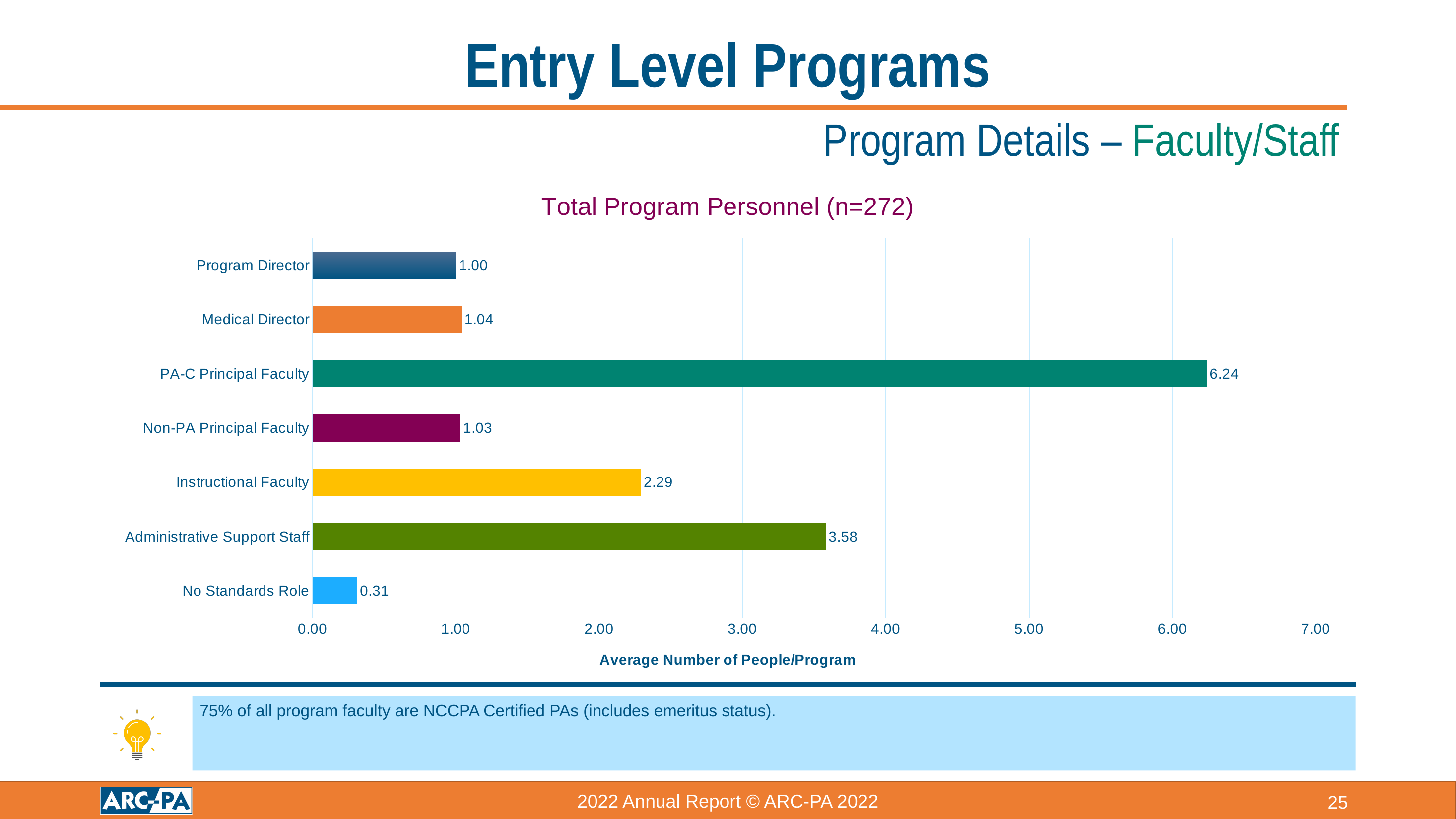
What is the value shown for Instructional Faculty? 2.29 What is the title of the chart? Total Program Personnel (n=272) How many categories are shown in the chart? 7 What is the value shown for No Standards Role? 0.31 Which category has the lowest average number of people per program? No Standards Role Which is larger, the value for Instructional Faculty or the value for Administrative Support Staff? Administrative Support Staff Is the value for PA-C Principal Faculty greater or less than 6.00? greater Which category has the highest average number of people per program? PA-C Principal Faculty What is the average number of PA-C Principal Faculty per program? 6.24 What is the difference between the values for PA-C Principal Faculty and Administrative Support Staff? 2.66 What kind of chart is shown on the slide? Bar chart What is the value shown for Administrative Support Staff? 3.58